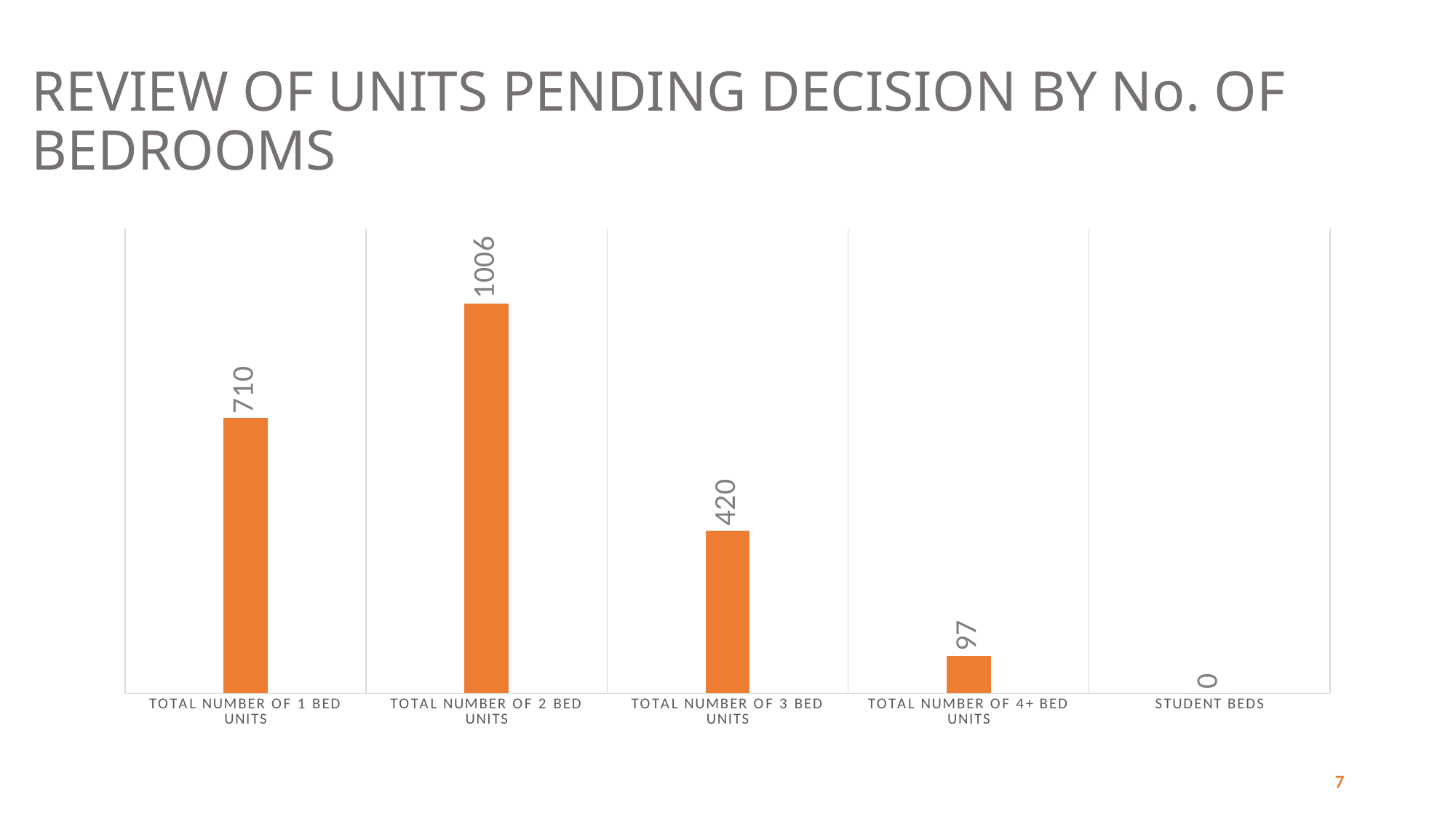
What is the value for Total Number of 2 Bed Units? 1006 What is the value for Total Number of 1 Bed Units? 710 Which is larger, the value for Total Number of 3 Bed Units or Total Number of 4+ Bed Units? Total Number of 3 Bed Units Which category has the lowest value? Student Beds What is the value for Student Beds? 0 How many categories are shown on the x axis? 5 What is the value for Total Number of 3 Bed Units? 420 What is the title of the slide? Review of Units Pending Decision by No. of Bedrooms What kind of chart is shown on the slide? Bar chart Which category has the highest value? Total Number of 2 Bed Units What is the value for Total Number of 4+ Bed Units? 97 What is the difference between the values for Total Number of 2 Bed Units and Total Number of 1 Bed Units? 296